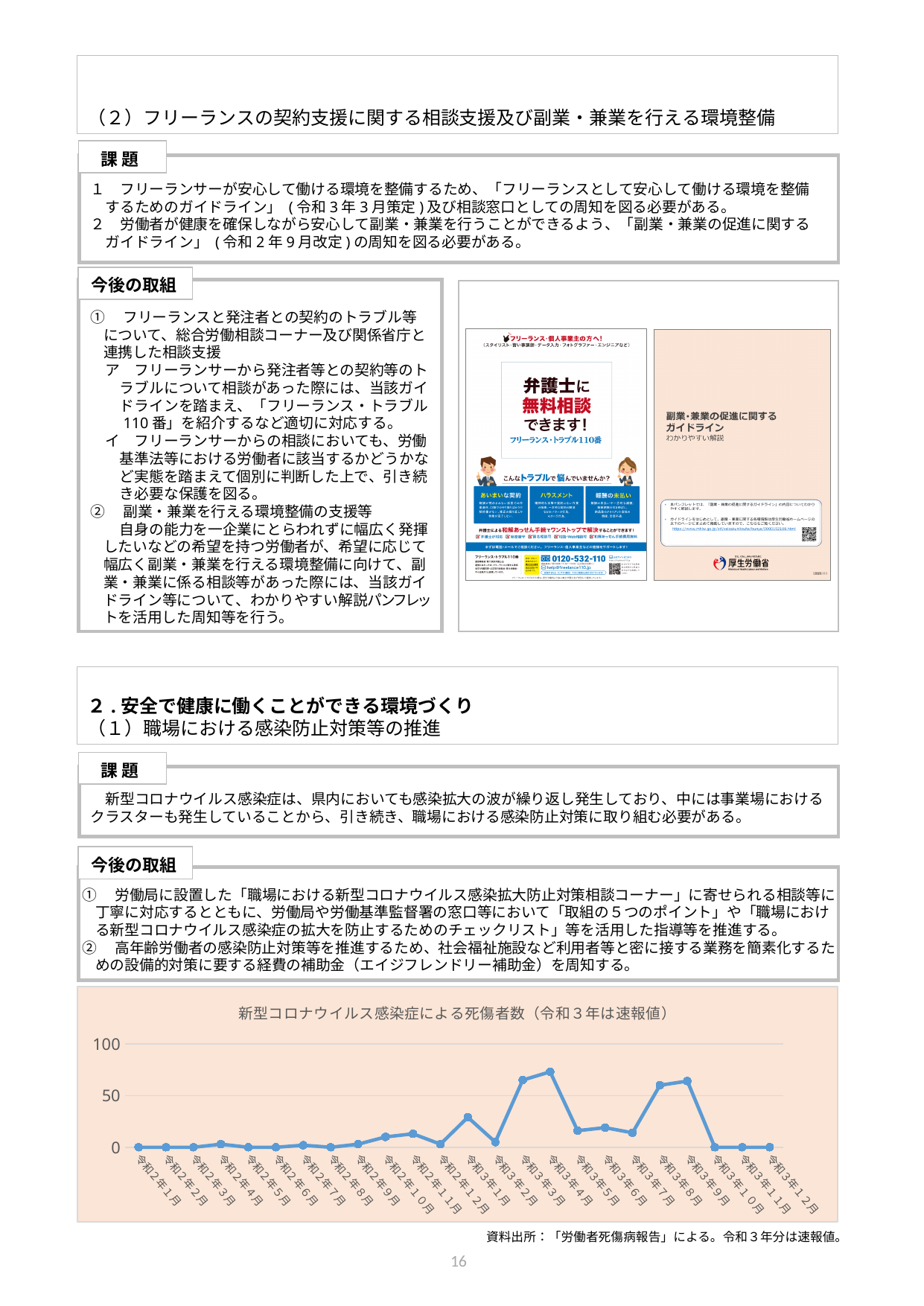
Which is larger, the value for 令和３年３月 or the value for 令和３年４月? 令和３年４月 Which month has the highest value on the chart? 令和３年４月 Is the value for 令和３年３月 greater or less than 100? less Which is larger, the value for 令和３年８月 or the value for 令和３年９月? 令和３年９月 Is the value for 令和３年３月 greater or less than 50? greater Is the value for 令和３年２月 greater or less than 50? less What kind of chart is shown at the bottom of the slide? line chart How many monthly data points are plotted on the chart? 24 Which is larger, the value for 令和２年１２月 or the value for 令和３年１月? 令和３年１月 What is the title of the chart at the bottom of the slide? 新型コロナウイルス感染症による死傷者数（令和３年は速報値）